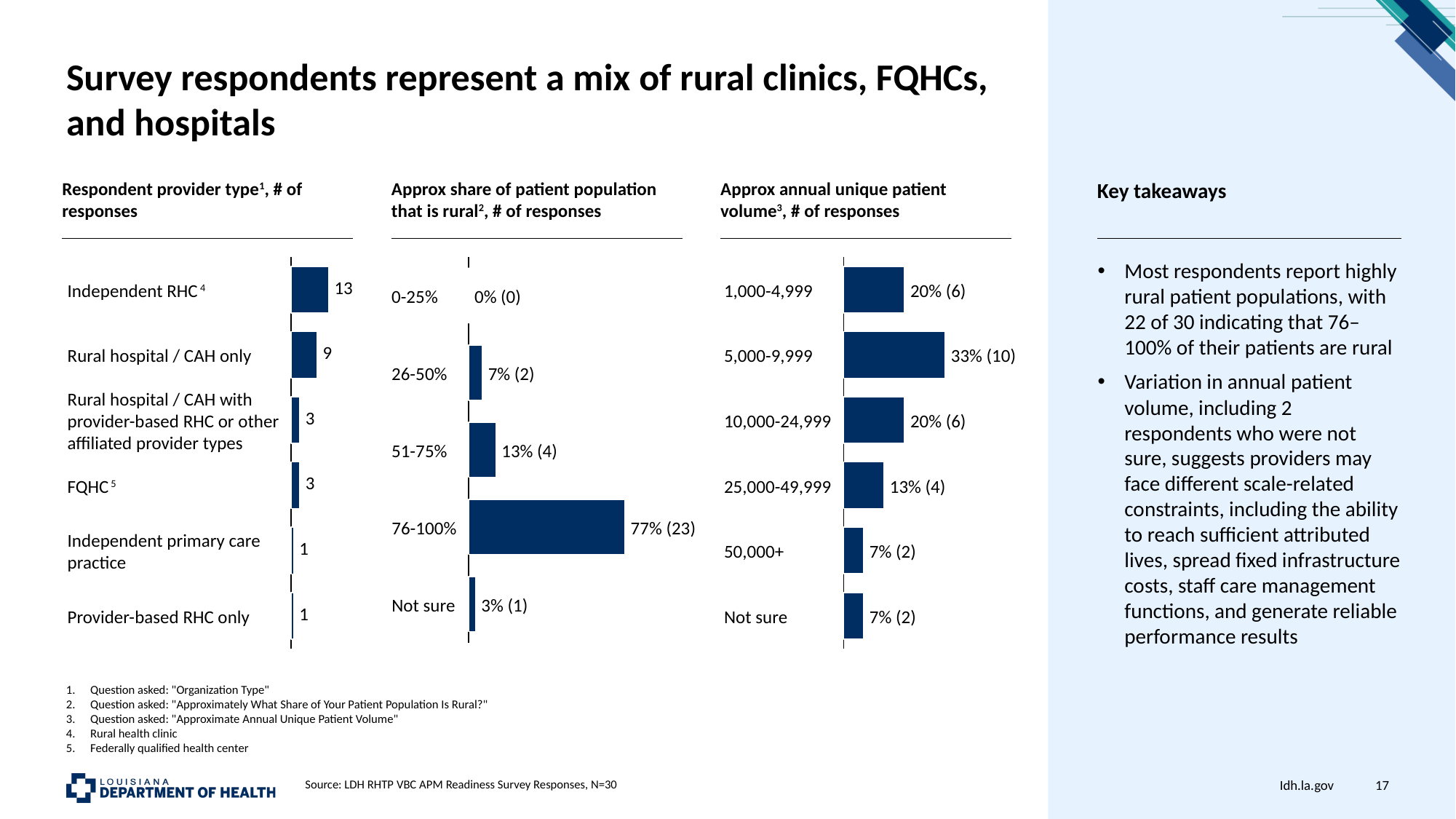
In the 'Respondent provider type' chart, what is the difference in responses between Independent RHC and Rural hospital / CAH only? 4 In the 'Approx share of patient population that is rural' chart, what is the value shown for 51-75%? 13% (4) In the 'Approx annual unique patient volume' chart, how many categories are shown? 6 In the 'Approx annual unique patient volume' chart, which is larger: the value for 1,000-4,999 or the value for 50,000+? 1,000-4,999 In the 'Approx annual unique patient volume' chart, what is the value shown for 25,000-49,999? 13% (4) In the 'Approx share of patient population that is rural' chart, which category has the lowest value? 0-25% In the 'Respondent provider type' chart, which provider type has the highest number of responses? Independent RHC In the 'Approx share of patient population that is rural' chart, what is the value shown for 76-100%? 77% (23) In the 'Approx annual unique patient volume' chart, which category has the highest value? 5,000-9,999 What type of chart is the 'Approx share of patient population that is rural' chart? Bar chart In the 'Respondent provider type' chart, how many responses are shown for Independent RHC? 13 In the 'Respondent provider type' chart, how many provider type categories are shown? 6